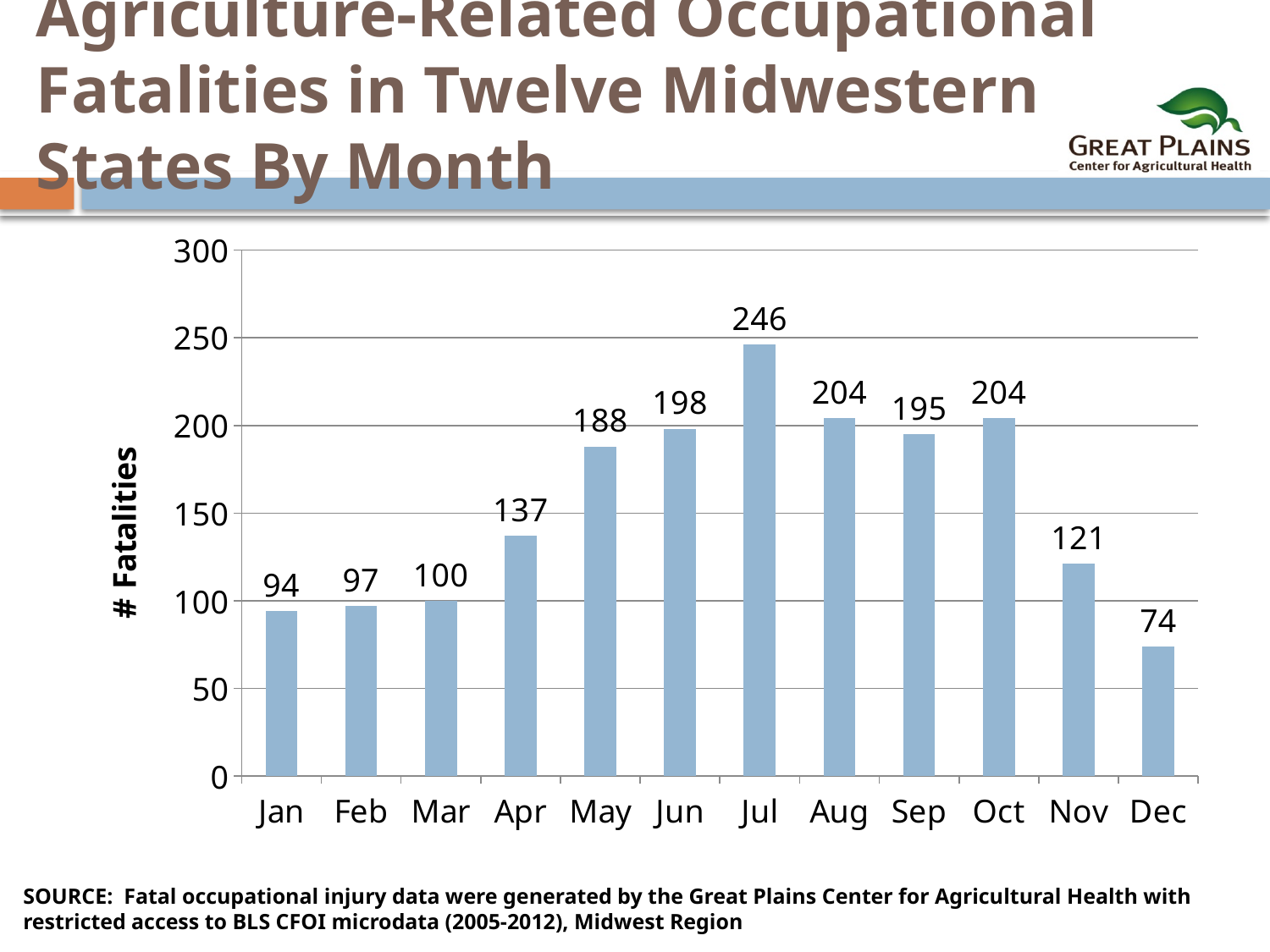
How many months are shown on the x axis? 12 What is the difference in fatalities between June and May? 10 Do the values rise or fall from January to July? rise What is the label of the vertical axis? # Fatalities How many fatalities are shown for July? 246 What is the difference in fatalities between July and December? 172 Is the value for September greater or less than 150? greater What is the number of fatalities for April? 137 Which month has the highest number of fatalities? Jul Which month has the lowest number of fatalities? Dec Which month has more fatalities, November or April? Apr What kind of chart is shown on the slide? bar chart